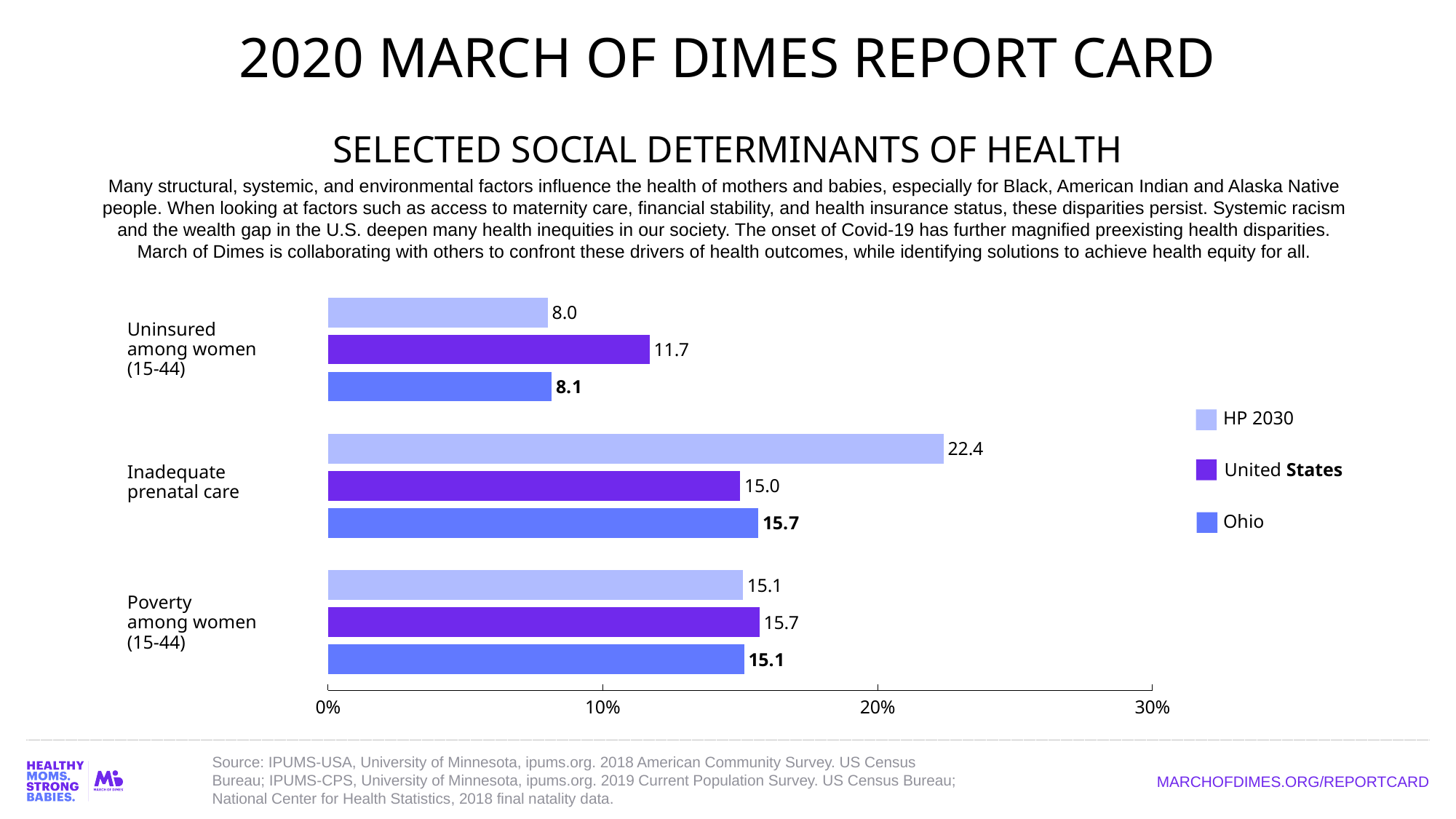
Which category has the highest HP 2030 value? Inadequate prenatal care How many series does the legend list? 3 What is the United States value for Uninsured among women (15-44)? 11.7 What kind of chart is shown on the slide? Bar chart How many categories are shown on the chart? 3 What is the difference between the HP 2030 and United States values for Inadequate prenatal care? 7.4 Is the HP 2030 value for Inadequate prenatal care greater or less than 20%? greater What is the HP 2030 value for Poverty among women (15-44)? 15.1 What is the Ohio value for Inadequate prenatal care? 15.7 What is the highest value shown on the x axis? 30% Which category has the lowest Ohio value? Uninsured among women (15-44) Which is larger for Uninsured among women (15-44): the United States value or the Ohio value? United States